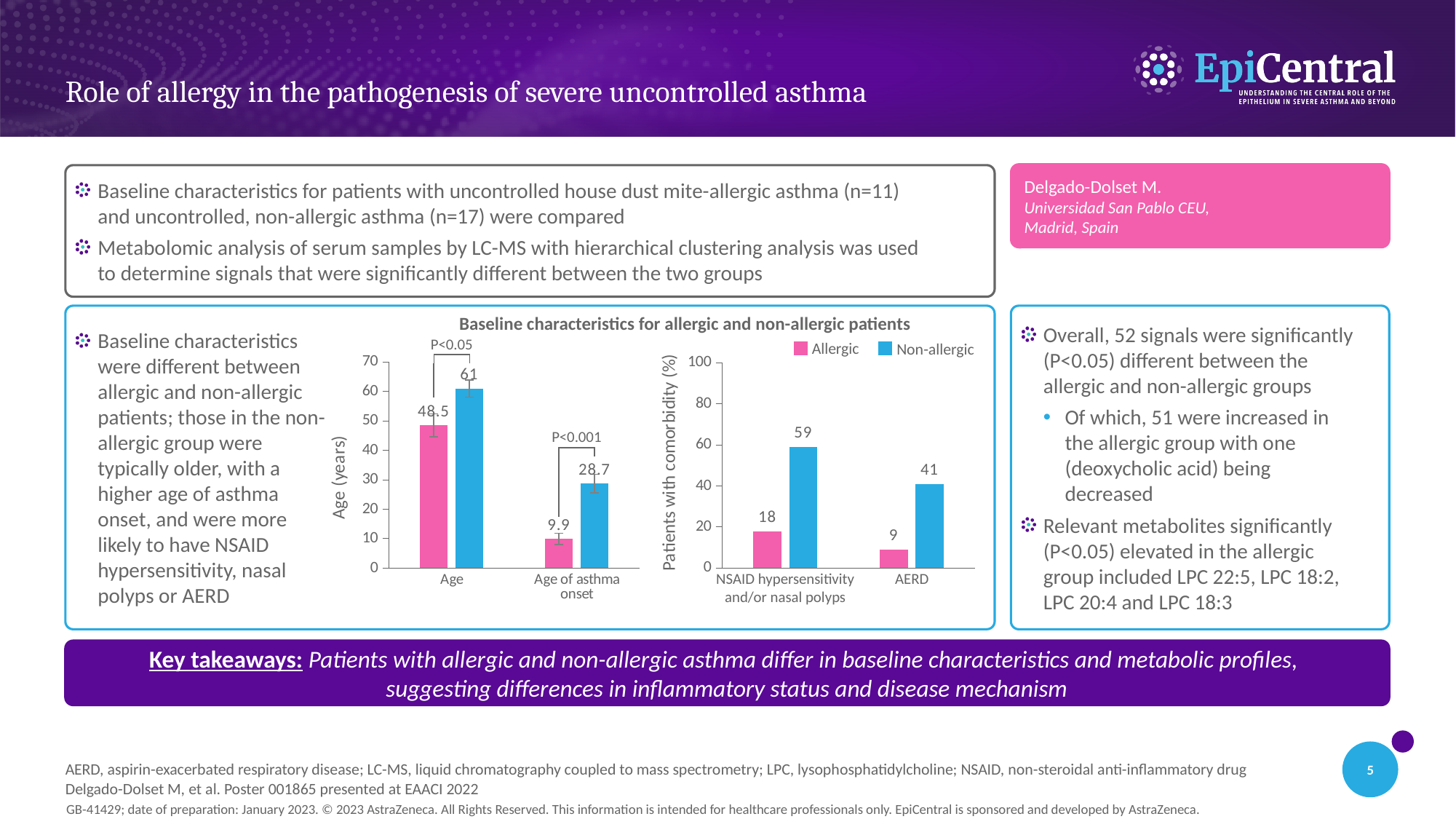
In the right chart (Patients with comorbidity), which bar is the highest? Non-allergic, NSAID hypersensitivity and/or nasal polyps How many series does the legend list for the baseline characteristics charts? 2 In the left chart (Age in years), what is the value for the Allergic group for Age of asthma onset? 9.9 In the right chart (Patients with comorbidity), what is the difference between the Non-allergic and Allergic values for AERD? 32 What is the title shown above the two charts? Baseline characteristics for allergic and non-allergic patients In the left chart (Age in years), what is the difference between the Non-allergic and Allergic values for Age of asthma onset? 18.8 In the right chart (Patients with comorbidity), what is the value for the Allergic group for AERD? 9 What kind of chart is the left chart (Age in years)? Bar chart In the right chart (Patients with comorbidity), which group has the higher value for NSAID hypersensitivity and/or nasal polyps? Non-allergic In the left chart (Age in years), which bar is the lowest? Allergic, Age of asthma onset In the left chart (Age in years), what is the value for the Non-allergic group for Age? 61 In the right chart (Patients with comorbidity), what is the value for the Non-allergic group for NSAID hypersensitivity and/or nasal polyps? 59